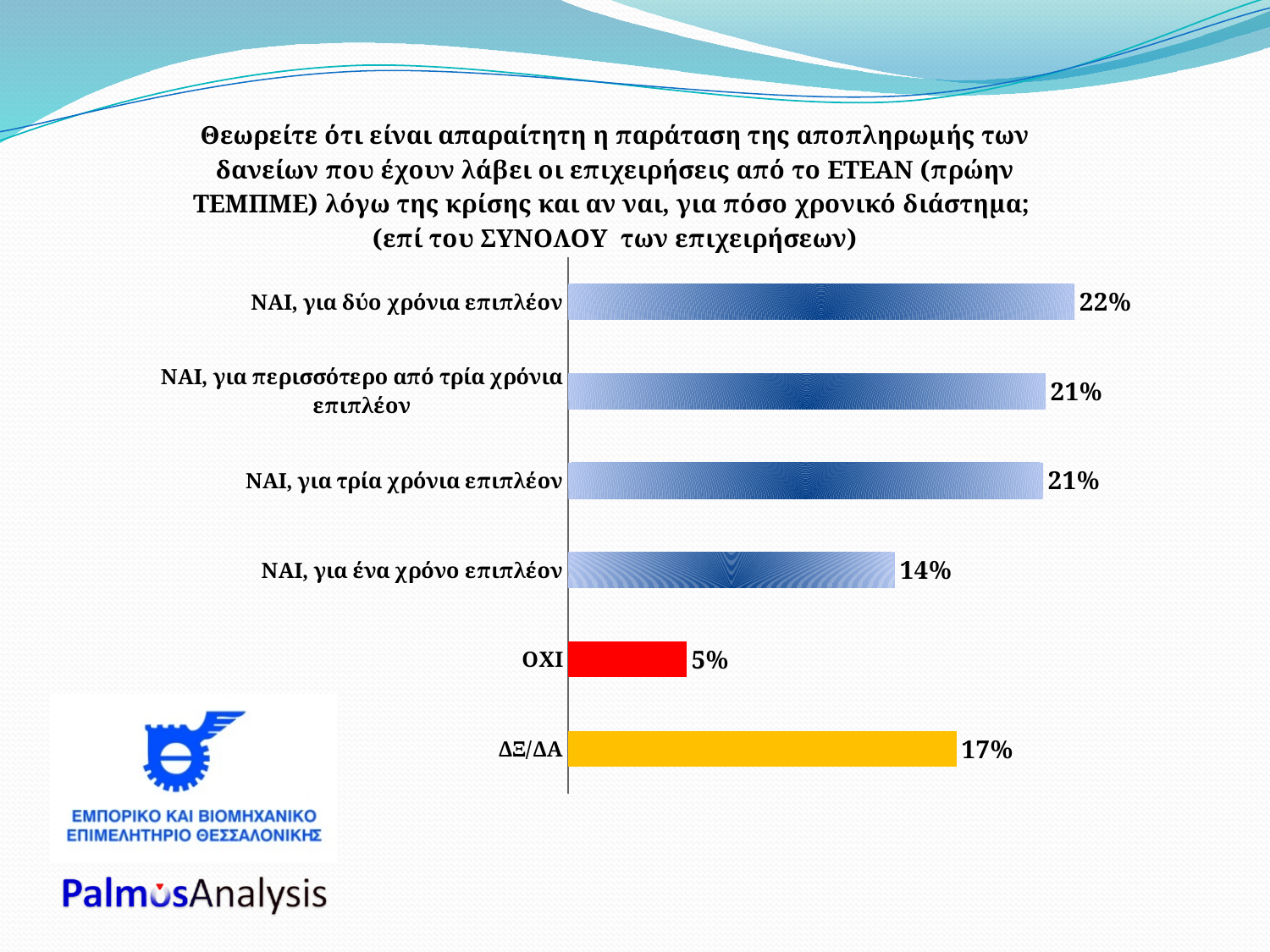
What kind of chart is shown on the slide? Bar chart What is the difference between the values for "ΔΞ/ΔΑ" and "ΟΧΙ"? 12% Which category has the highest value? ΝΑΙ, για δύο χρόνια επιπλέον What is the value for "ΝΑΙ, για δύο χρόνια επιπλέον"? 22% How many categories are shown in the chart? 6 Which category has the lowest value? ΟΧΙ What is the difference between the values for "ΝΑΙ, για δύο χρόνια επιπλέον" and "ΝΑΙ, για ένα χρόνο επιπλέον"? 8% Which is larger, the value for "ΔΞ/ΔΑ" or the value for "ΝΑΙ, για ένα χρόνο επιπλέον"? ΔΞ/ΔΑ What is the value for "ΔΞ/ΔΑ"? 17% What is the value for "ΟΧΙ"? 5% What colour is the bar for "ΟΧΙ"? Red What is the value for "ΝΑΙ, για ένα χρόνο επιπλέον"? 14%